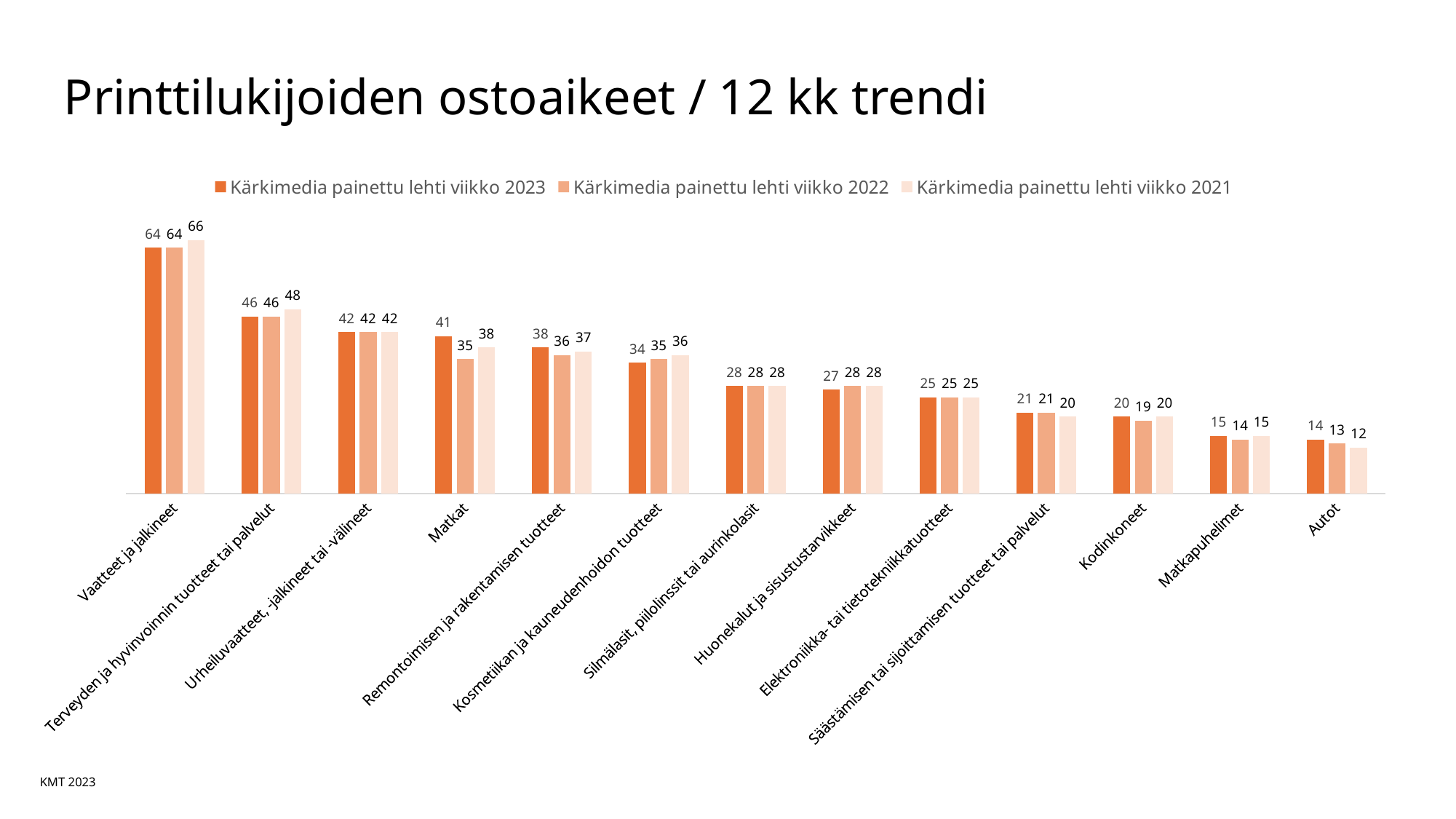
What is the difference between the 2023 and 2022 values for Matkat? 6 What is the value for Autot in the Kärkimedia painettu lehti viikko 2022 series? 13 Which is larger for Kosmetiikan ja kauneudenhoidon tuotteet: the 2023 value or the 2021 value? The 2021 value Which category has the highest value in the Kärkimedia painettu lehti viikko 2023 series? Vaatteet ja jalkineet What is the title of the chart? Printtilukijoiden ostoaikeet / 12 kk trendi Do the values in the Kärkimedia painettu lehti viikko 2023 series rise or fall from left to right along the x axis? Fall How many series does the legend list? 3 What is the value for Matkat in the Kärkimedia painettu lehti viikko 2023 series? 41 Which category has the lowest value in the Kärkimedia painettu lehti viikko 2021 series? Autot What type of chart is shown on the slide? Bar chart How many categories are shown on the x axis? 13 What is the value for Vaatteet ja jalkineet in the Kärkimedia painettu lehti viikko 2021 series? 66